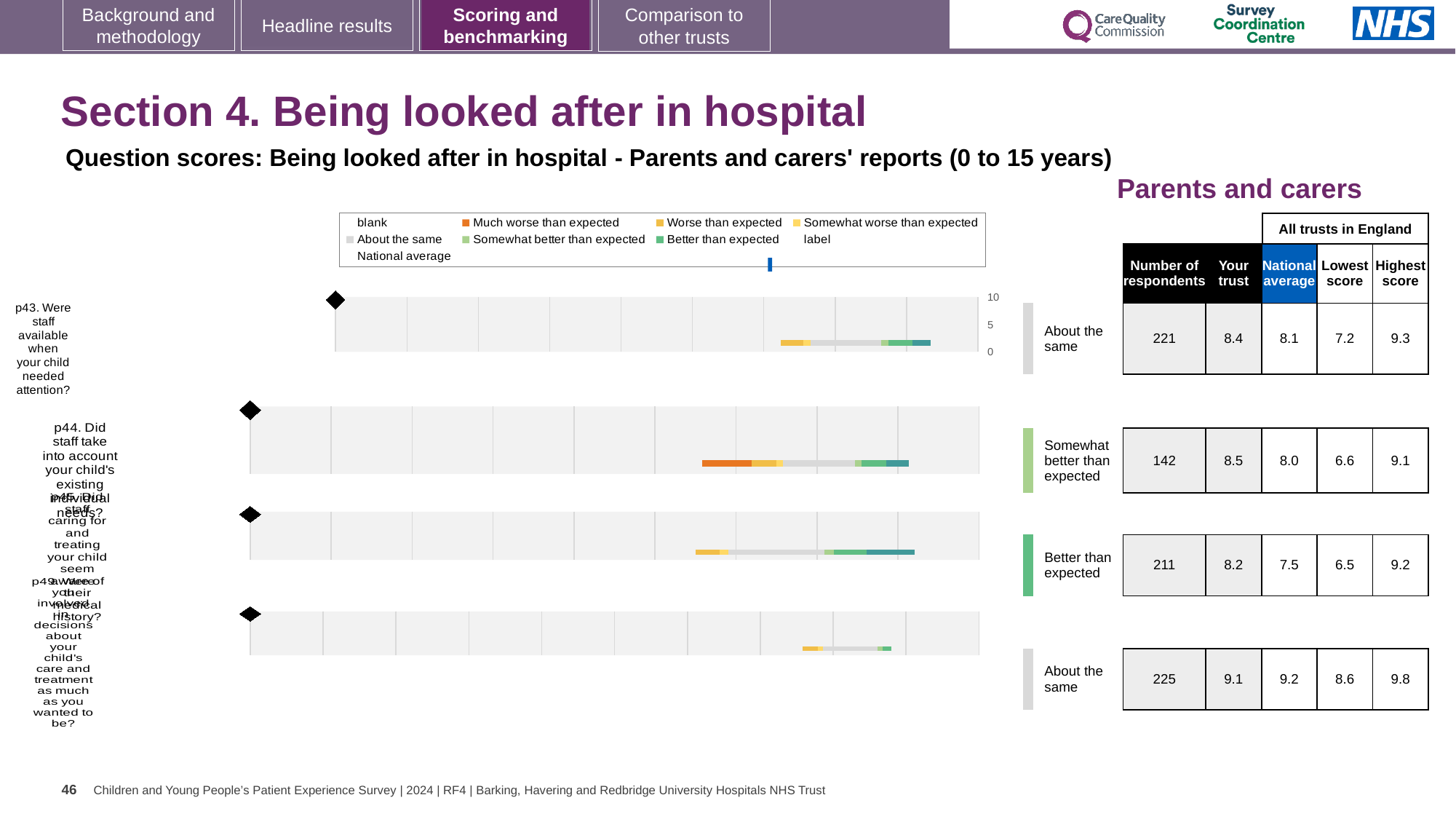
For p43, which is larger: the trust's score or the national average? Your trust What is the 'Your trust' score for p43 (Were staff available when your child needed attention?)? 8.4 What is the national average score for p43 (Were staff available when your child needed attention?)? 8.1 What kind of chart is shown on the slide? Bar chart What is the 'Your trust' score for p44 (Did staff take into account your child's existing individual needs?)? 8.5 What is the subtitle of the chart? Question scores: Being looked after in hospital - Parents and carers' reports (0 to 15 years) How many respondents answered p43 (Were staff available when your child needed attention?)? 221 What is the maximum value shown on the chart's score axis? 10 Which of the four questions has the highest 'Your trust' score, and what is it? The fourth question (p49), 9.1 What is the highest score across all trusts in England for p43 (Were staff available when your child needed attention?)? 9.3 How many questions (bars) are plotted in the chart? 4 By how much does the trust's score for p43 exceed the national average? 0.3